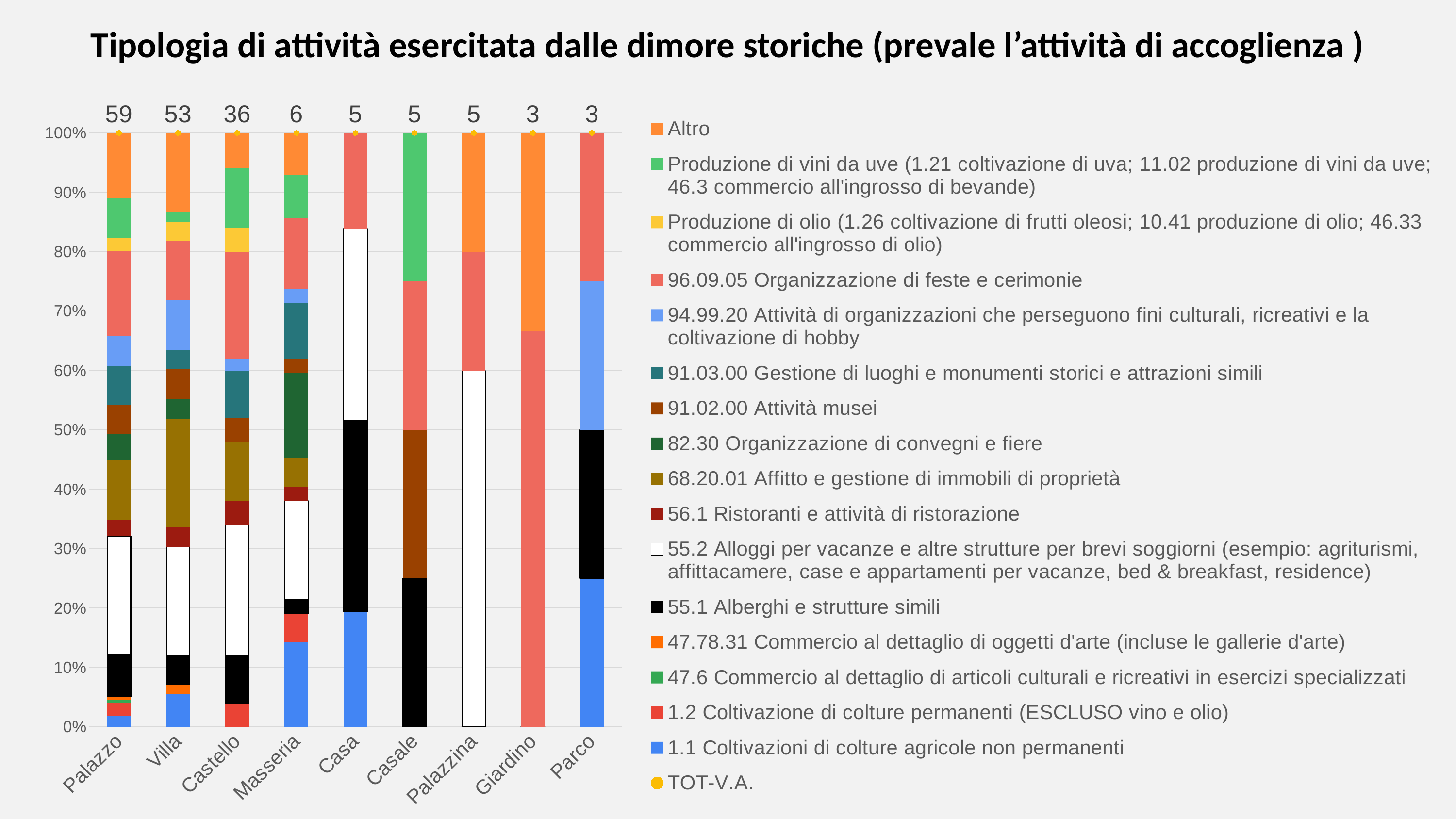
What is the difference between the TOT-V.A. values of Palazzo and Villa? 6 What kind of chart is shown on the slide? Stacked bar chart Which category has the highest TOT-V.A. value? Palazzo What is the TOT-V.A. value shown above the Castello bar? 36 What is the TOT-V.A. value shown above the Palazzo bar? 59 Is the share of '96.09.05 Organizzazione di feste e cerimonie' for Giardino greater or less than 60%? greater Which has a larger TOT-V.A. value, Castello or Masseria? Castello How many categories are shown on the x axis? 9 Is the share of '55.2 Alloggi per vacanze' (white segment) for Palazzina greater or less than 50%? greater What is the TOT-V.A. value shown above the Masseria bar? 6 How many entries does the legend list? 17 Do the TOT-V.A. values rise or fall from Palazzo to Parco along the x axis? fall